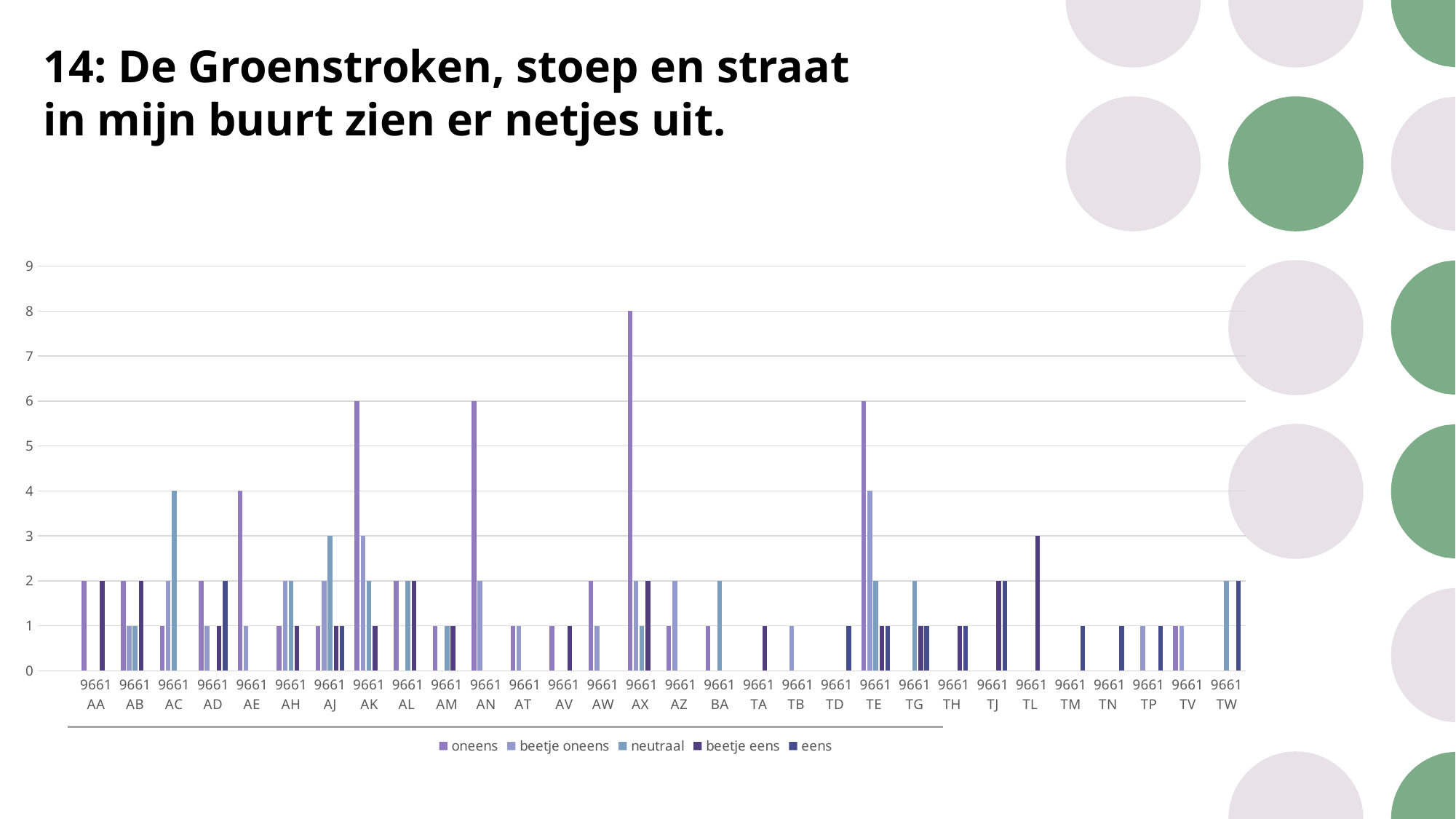
What is the value of 'neutraal' for 9661 AC? 4 What is the value of 'beetje eens' for 9661 TL? 3 Which series is listed first in the legend? oneens What kind of chart is shown on the slide? bar chart How many series does the legend list? 5 Which category has the tallest bar in the chart? 9661 AX How many categories are shown on the x axis? 30 What is the value of 'oneens' for 9661 AE? 4 What is the difference between 'oneens' for 9661 AX and 'oneens' for 9661 TE? 2 What is the value of 'oneens' for 9661 AX? 8 Which is larger: 'oneens' for 9661 AX or 'oneens' for 9661 AK? 9661 AX What is the value of 'beetje oneens' for 9661 TE? 4